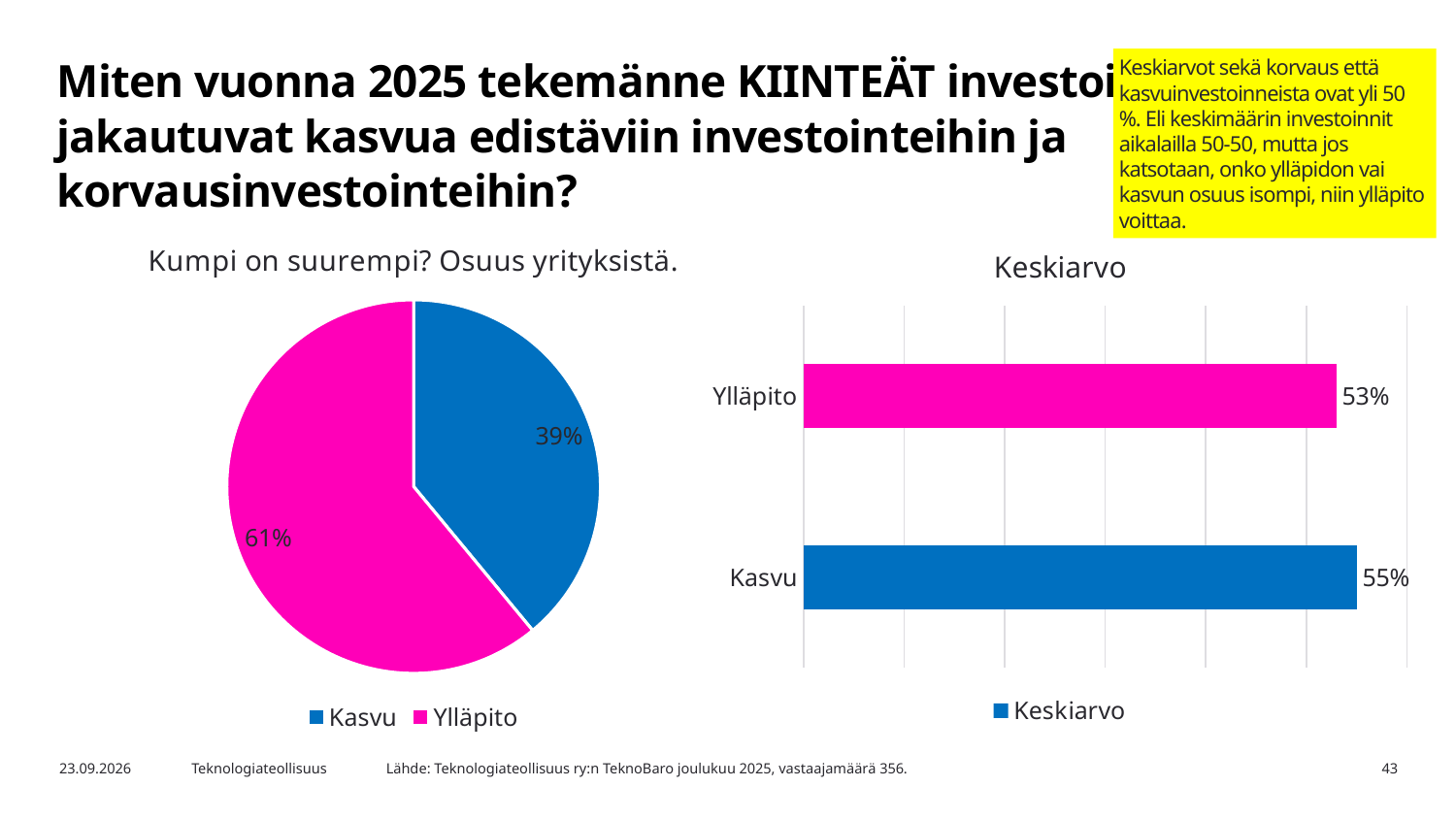
In the chart titled "Keskiarvo", what is the value for Ylläpito? 53% In the chart titled "Keskiarvo", what is the value for Kasvu? 55% In the pie chart titled "Kumpi on suurempi? Osuus yrityksistä.", what is the share for Ylläpito? 61% In the pie chart on the left, which category has the larger share? Ylläpito What kind of chart is the chart titled "Keskiarvo"? Bar chart How many slices does the pie chart on the left have? 2 In the chart titled "Keskiarvo", which category has the higher value? Kasvu In the pie chart titled "Kumpi on suurempi? Osuus yrityksistä.", what is the share for Kasvu? 39% In the chart titled "Keskiarvo", what is the difference in percentage points between Kasvu and Ylläpito? 2 In the pie chart on the left, what is the difference in percentage points between Ylläpito and Kasvu? 22 In the pie chart on the left, what colour is the Kasvu slice? Blue How many series does the legend of the chart titled "Keskiarvo" list? 1